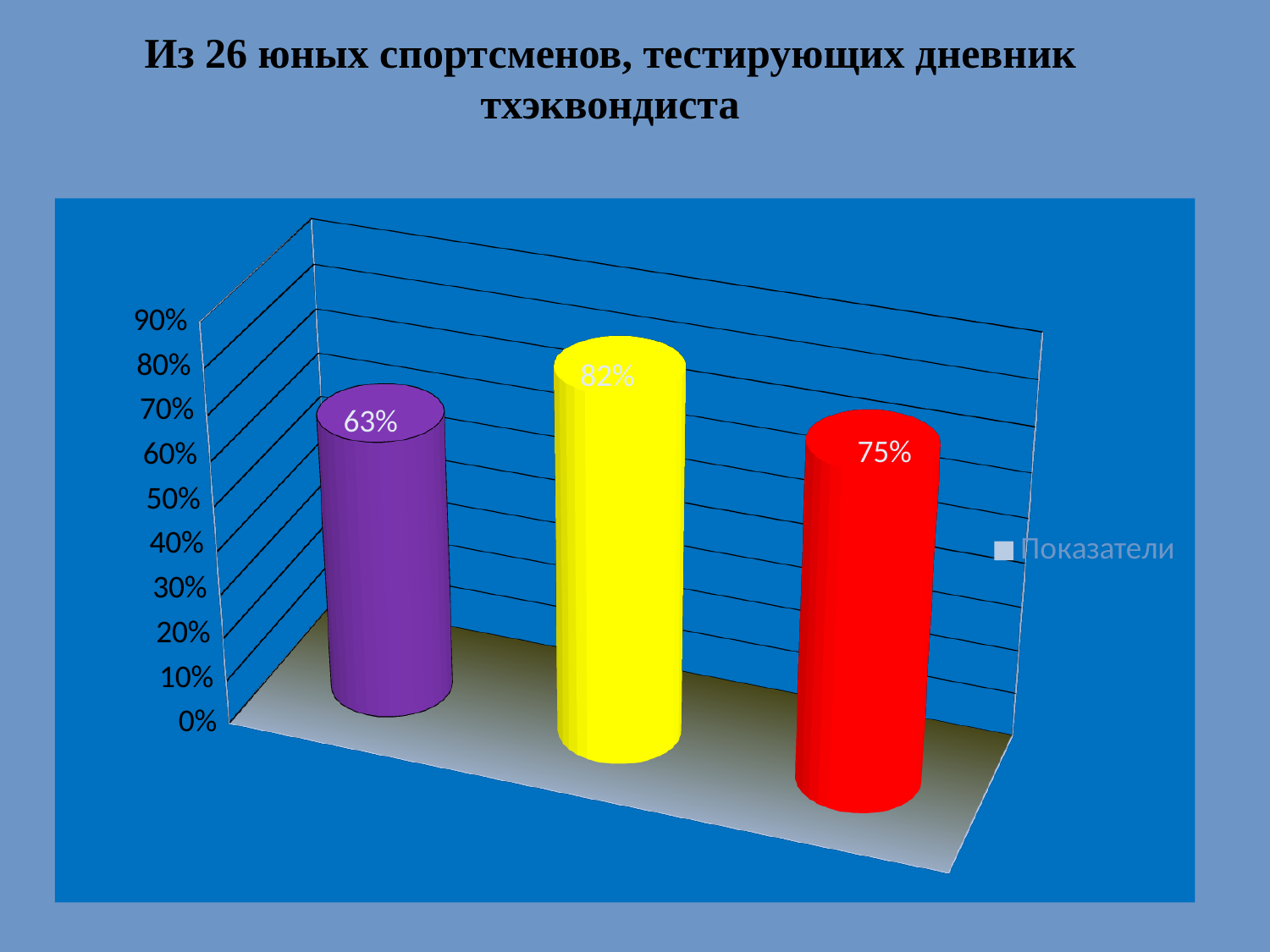
What is the difference between the red bar and the purple bar? 12% What kind of chart is shown on the slide? Bar chart How many bars are plotted in the chart? 3 What value is shown on the purple bar? 63% What value is shown on the red bar? 75% Which bar has the highest value? The yellow bar (82%) Which is larger, the value of the red bar or the value of the purple bar? The red bar What is the difference between the yellow bar and the purple bar? 19% What is the legend entry of the chart? Показатели Which bar has the lowest value? The purple bar (63%) What value is shown on the yellow bar? 82% How many series does the legend list? 1